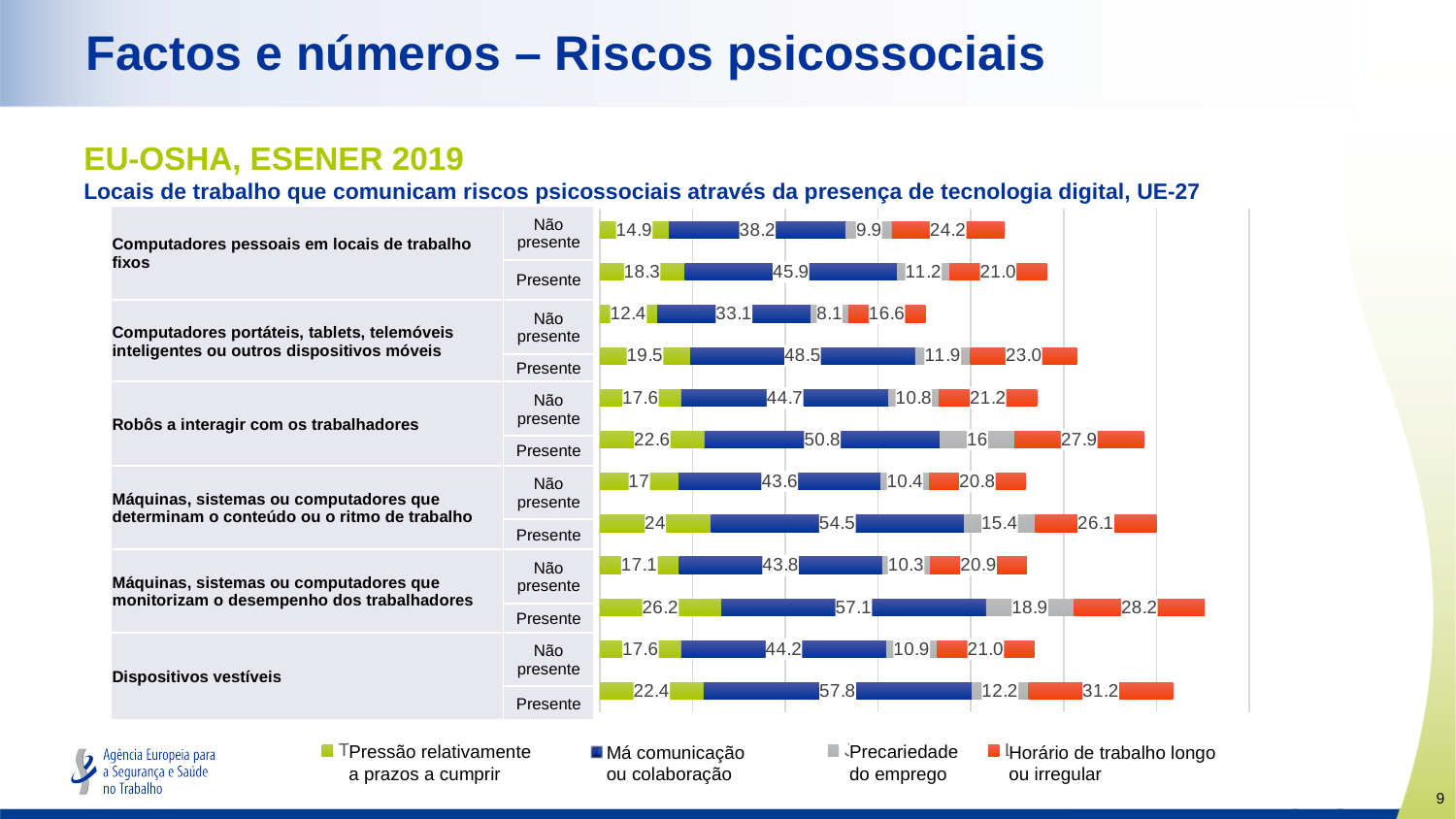
What is the value for 'Má comunicação ou colaboração' for 'Computadores pessoais em locais de trabalho fixos', 'Presente'? 45.9 For 'Computadores portáteis, tablets, telemóveis inteligentes ou outros dispositivos móveis', is the 'Má comunicação ou colaboração' value larger for 'Presente' or 'Não presente'? Presente How many series does the legend list? 4 What is the difference in 'Horário de trabalho longo ou irregular' between 'Presente' and 'Não presente' for 'Robôs a interagir com os trabalhadores'? 6.7 How many stacked bars are plotted in the chart? 12 What is the value for 'Horário de trabalho longo ou irregular' for 'Dispositivos vestíveis', 'Presente'? 31.2 What kind of chart is shown on the slide? Stacked bar chart Which bar has the lowest value for 'Precariedade do emprego'? Computadores portáteis, tablets, telemóveis inteligentes ou outros dispositivos móveis, Não presente What is the value for 'Precariedade do emprego' for 'Robôs a interagir com os trabalhadores', 'Presente'? 16 What is the total of the stacked bar for 'Computadores portáteis, tablets, telemóveis inteligentes ou outros dispositivos móveis', 'Não presente'? 70.2 Which bar has the highest value for 'Pressão relativamente a prazos a cumprir'? Máquinas, sistemas ou computadores que monitorizam o desempenho dos trabalhadores, Presente What is the total of the stacked bar for 'Dispositivos vestíveis', 'Presente'? 123.6